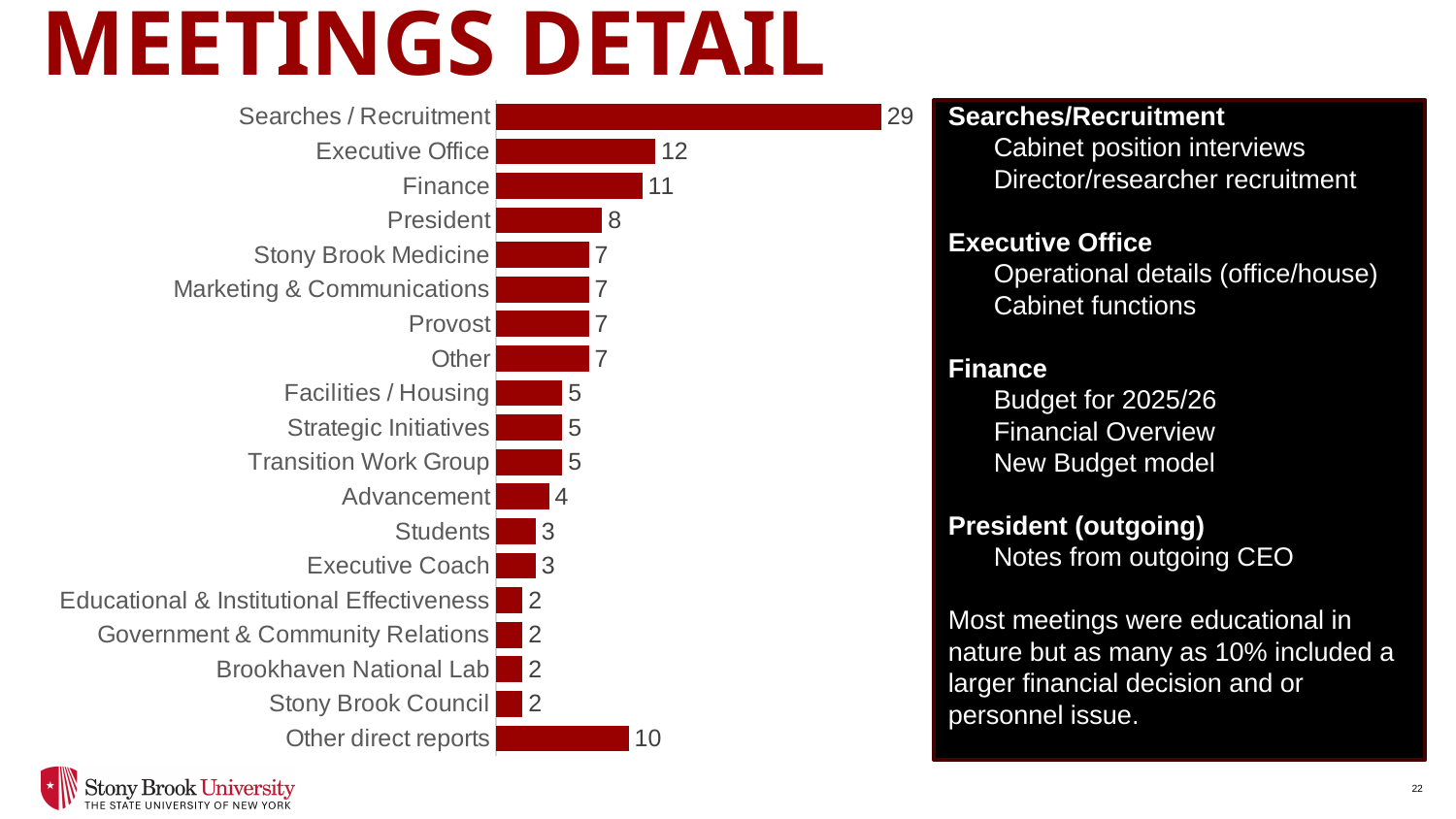
How many categories are shown in the chart? 19 What is the difference between the values for President and Students? 5 How many meetings are shown for Searches / Recruitment? 29 What is the difference between the values for Searches / Recruitment and Executive Office? 17 What is the value for Finance? 11 Which is larger, the value for Provost or the value for Facilities / Housing? Provost Which category has the highest value? Searches / Recruitment What kind of chart is shown on the slide? bar chart What is the value for Stony Brook Council? 2 What is the value for Advancement? 4 What is the value for Other direct reports? 10 Which is larger, the value for Executive Office or the value for Other direct reports? Executive Office